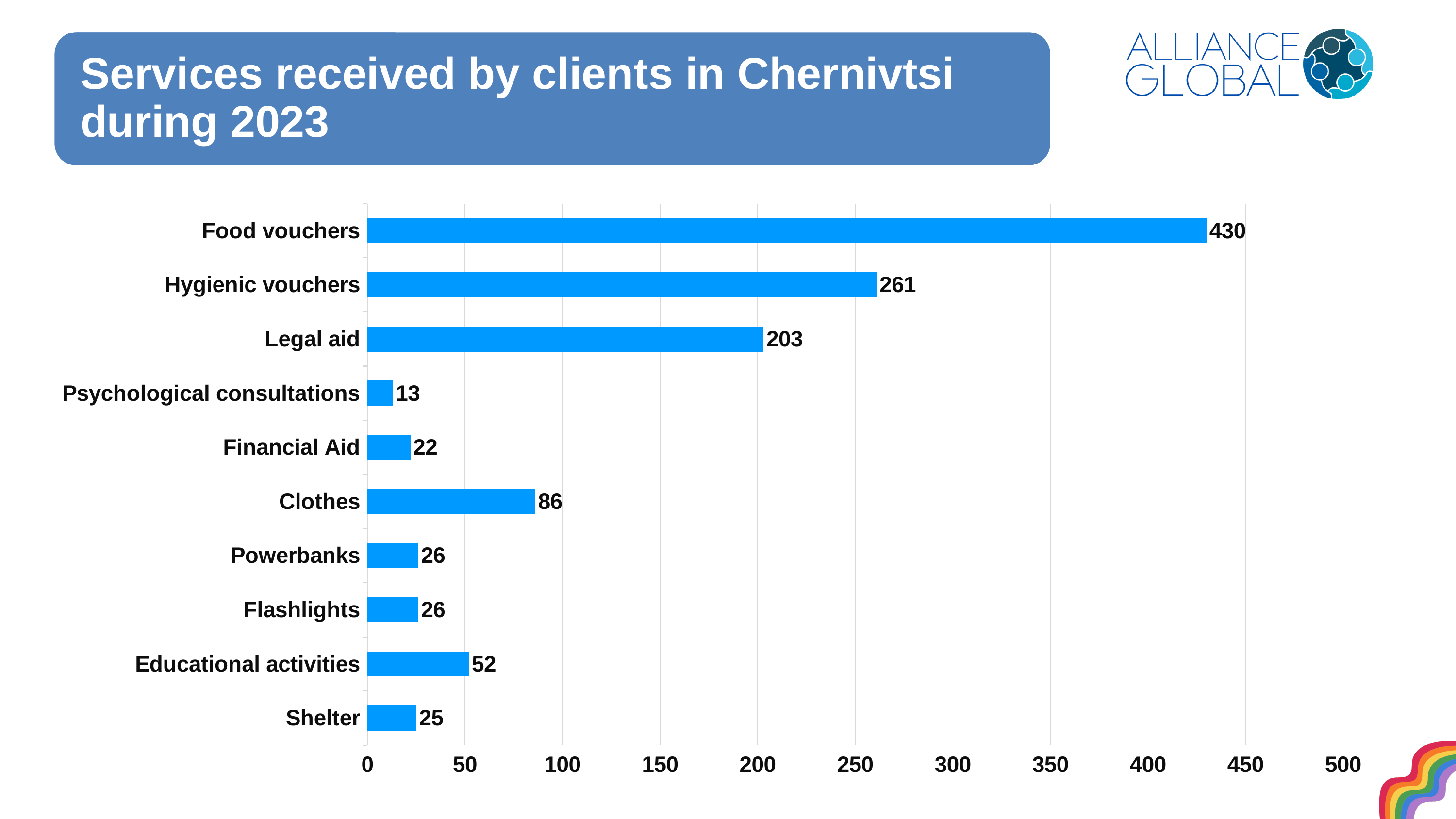
Which is larger, the value for Clothes or the value for Educational activities? Clothes Which category has the lowest value? Psychological consultations What is the title of the slide? Services received by clients in Chernivtsi during 2023 What is the value for Food vouchers? 430 Is the value for Hygienic vouchers greater or less than 250? greater How many categories are shown in the chart? 10 What is the value for Educational activities? 52 What is the difference between the values for Food vouchers and Hygienic vouchers? 169 Which category has the highest value? Food vouchers What kind of chart is shown on the slide? Bar chart What is the value for Psychological consultations? 13 What is the value for Legal aid? 203